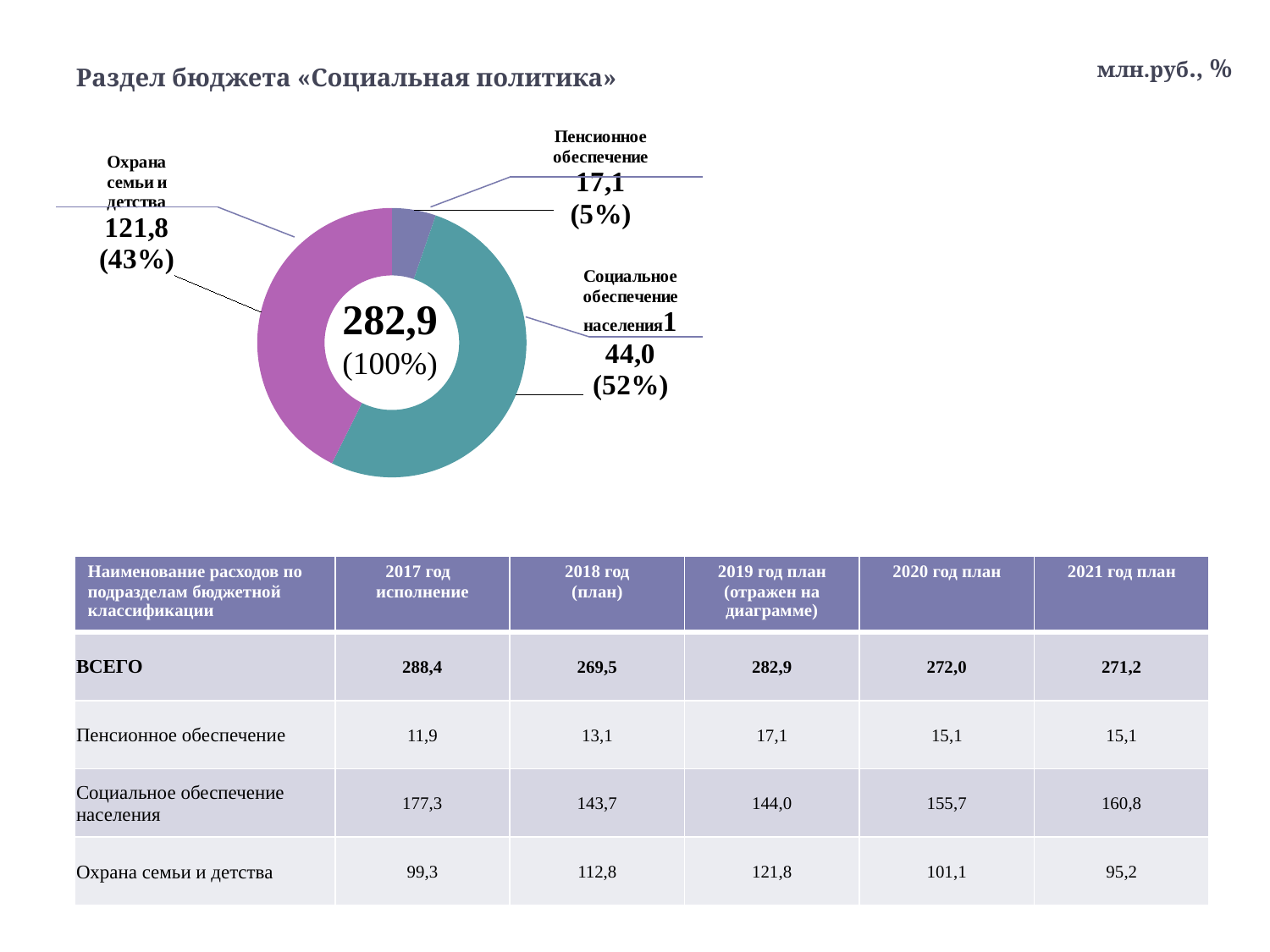
Which category has the smallest slice in the donut chart? Пенсионное обеспечение What is the difference between the values for «Социальное обеспечение населения» and «Охрана семьи и детства» on the donut chart? 22,2 How many slices does the donut chart have? 3 What total value is shown in the centre of the donut chart? 282,9 What share of the donut chart does «Пенсионное обеспечение» take? 5% Which category has the largest slice in the donut chart? Социальное обеспечение населения What share of the donut chart does «Социальное обеспечение населения» take? 52% Which is larger on the donut chart: «Охрана семьи и детства» or «Пенсионное обеспечение»? Охрана семьи и детства What kind of chart is shown on the slide? Donut (pie) chart What value is shown for «Социальное обеспечение населения» on the donut chart? 144,0 What value is shown for «Пенсионное обеспечение» on the donut chart? 17,1 What value is shown for «Охрана семьи и детства» on the donut chart? 121,8